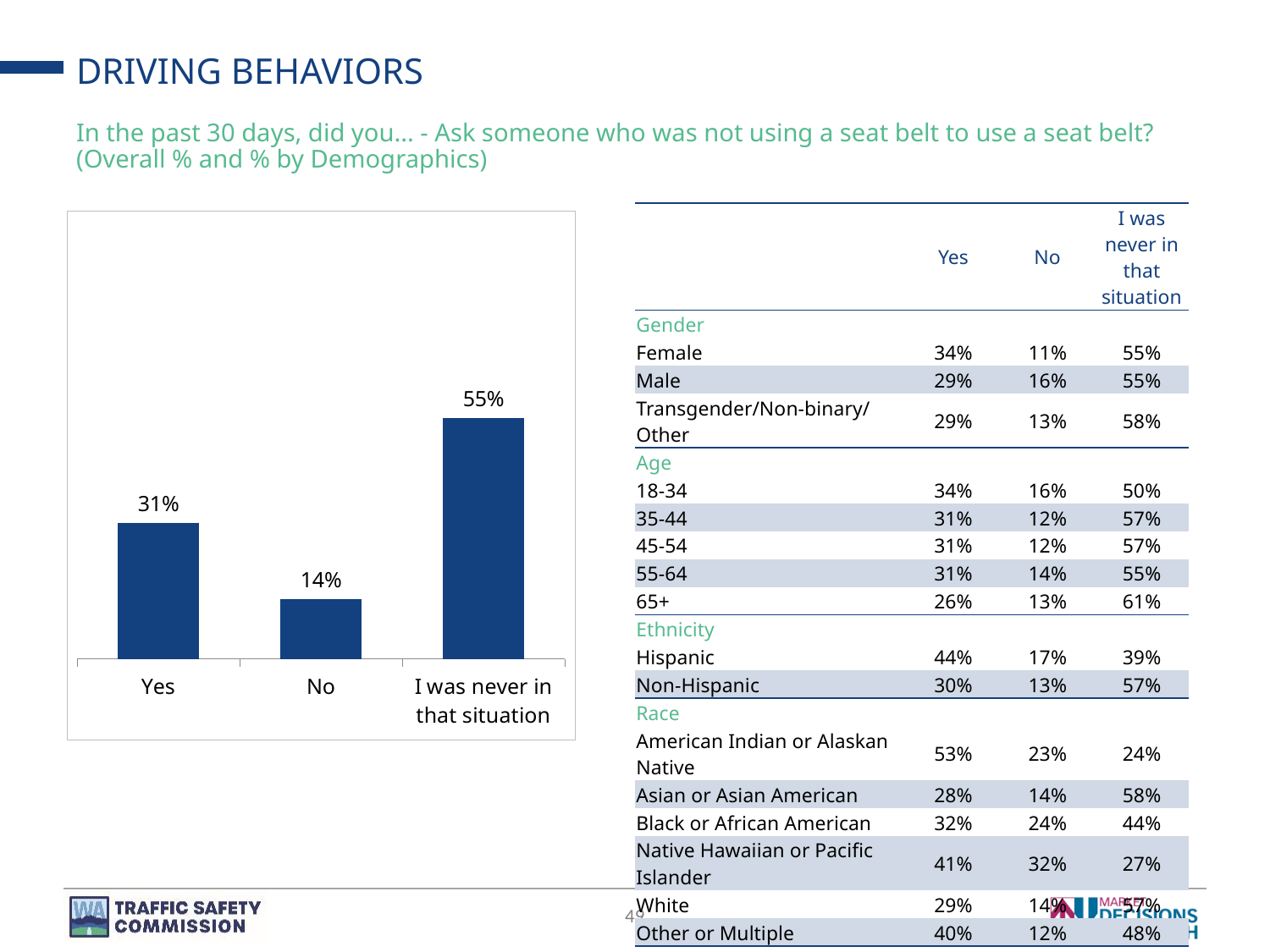
What kind of chart is shown on the slide? Bar chart What is the difference between the values for "Yes" and "No" in the bar chart? 17% What is the value for "No" in the bar chart? 14% Which category has the highest value in the bar chart? I was never in that situation What is the total of the three values shown in the bar chart? 100% What are the three category labels on the x axis of the bar chart? Yes, No, I was never in that situation Which category has the lowest value in the bar chart? No In the bar chart, which is larger: the value for "Yes" or the value for "No"? Yes What is the value for "Yes" in the bar chart? 31% What is the difference between the values for "I was never in that situation" and "Yes" in the bar chart? 24% How many categories are shown in the bar chart? 3 What is the value for "I was never in that situation" in the bar chart? 55%